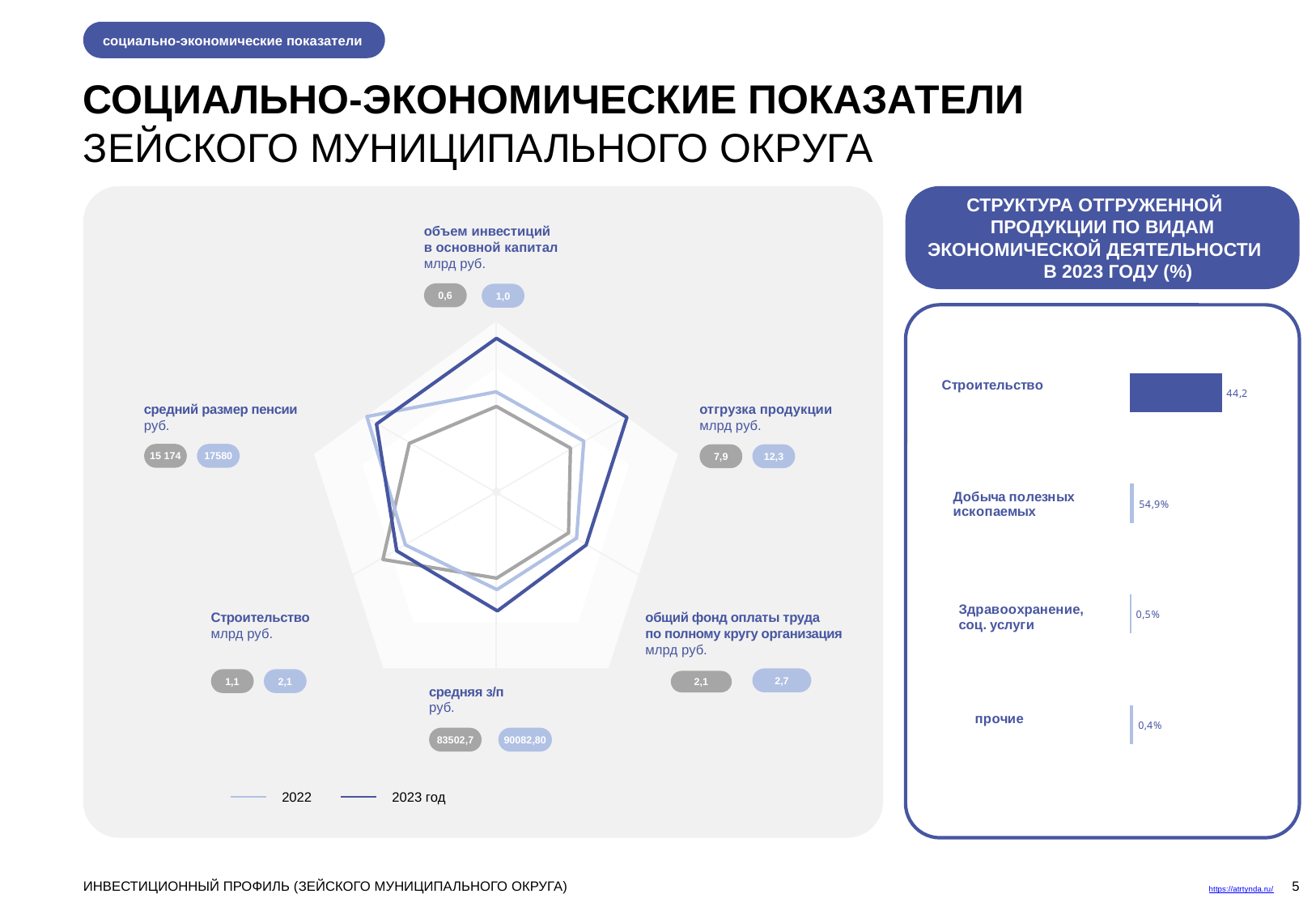
In the radar chart on the left, what two values are printed for 'средняя з/п, руб.'? 83502,7 and 90082,80 In the right-hand chart 'Структура отгруженной продукции', what value is shown for Строительство? 44,2 How many series does the legend of the radar chart on the left list? 2 What kind of chart is the one on the right titled 'Структура отгруженной продукции по видам экономической деятельности в 2023 году (%)'? bar chart In the right-hand chart 'Структура отгруженной продукции', what value is shown for Добыча полезных ископаемых? 54,9% In the right-hand chart 'Структура отгруженной продукции', which category has the lowest value? прочие What kind of chart is the large chart on the left of the slide? radar chart In the radar chart on the left, what two values are printed for 'отгрузка продукции, млрд руб.'? 7,9 and 12,3 In the right-hand chart 'Структура отгруженной продукции', what value is shown for Здравоохранение, соц. услуги? 0,5% In the radar chart on the left, what two values are printed for 'средний размер пенсии, руб.'? 15 174 and 17580 In the right-hand chart, which is larger: the value for Здравоохранение, соц. услуги or the value for прочие? Здравоохранение, соц. услуги How many categories are listed in the right-hand chart 'Структура отгруженной продукции'? 4